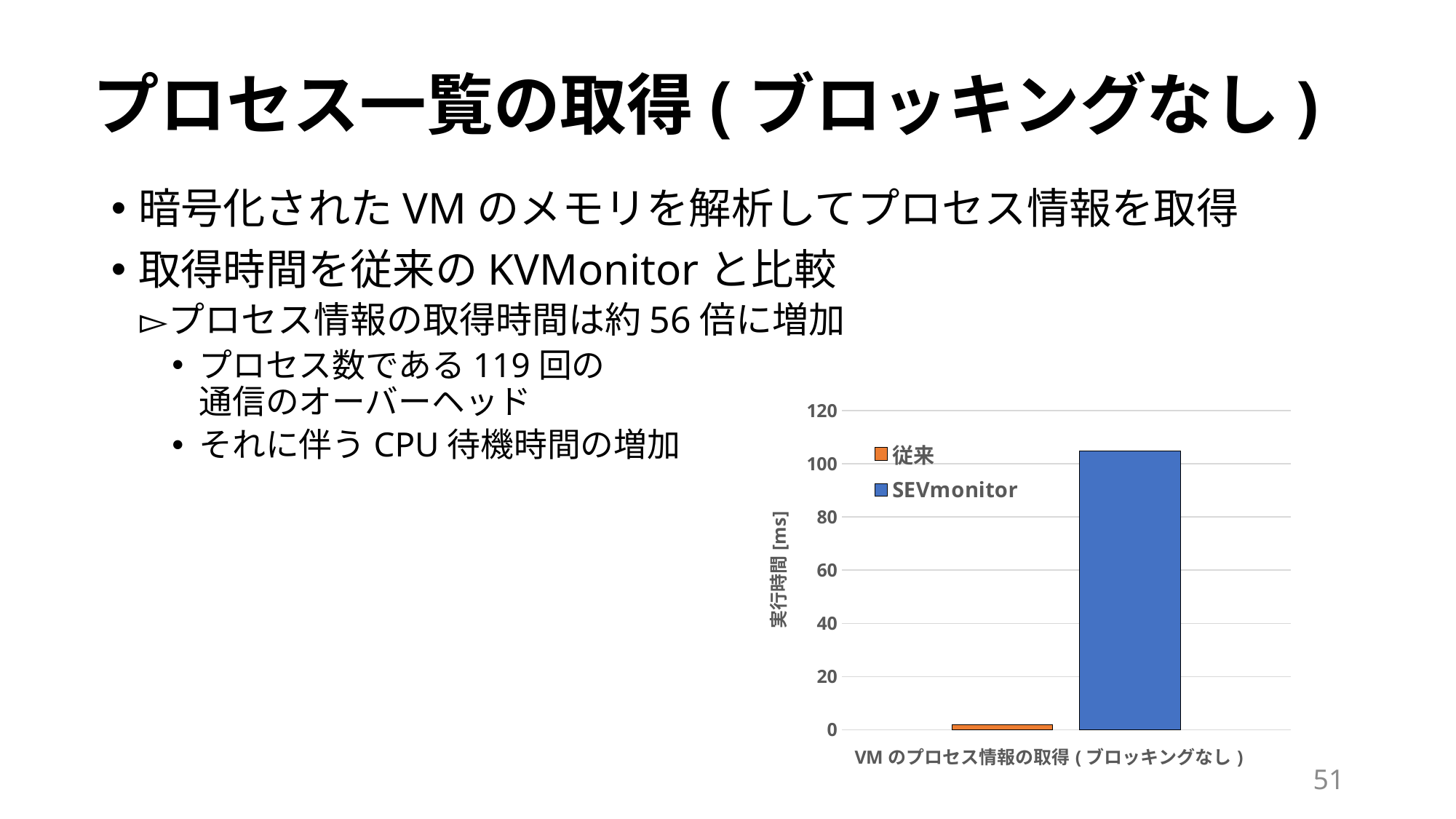
Is the value for 従来 greater or less than 20? less What is the label of the y axis of the chart? 実行時間 [ms] Which series has the lowest value in the chart? 従来 Which series has the higher value in the chart, 従来 or SEVmonitor? SEVmonitor Is the value for SEVmonitor greater or less than 100? greater What kind of chart is shown on the slide? bar chart Which colour represents the SEVmonitor series in the chart? blue Which series has the highest value in the chart? SEVmonitor How many categories are shown on the x axis of the chart? 1 Is the value for SEVmonitor greater or less than 120? less How many series does the chart legend list? 2